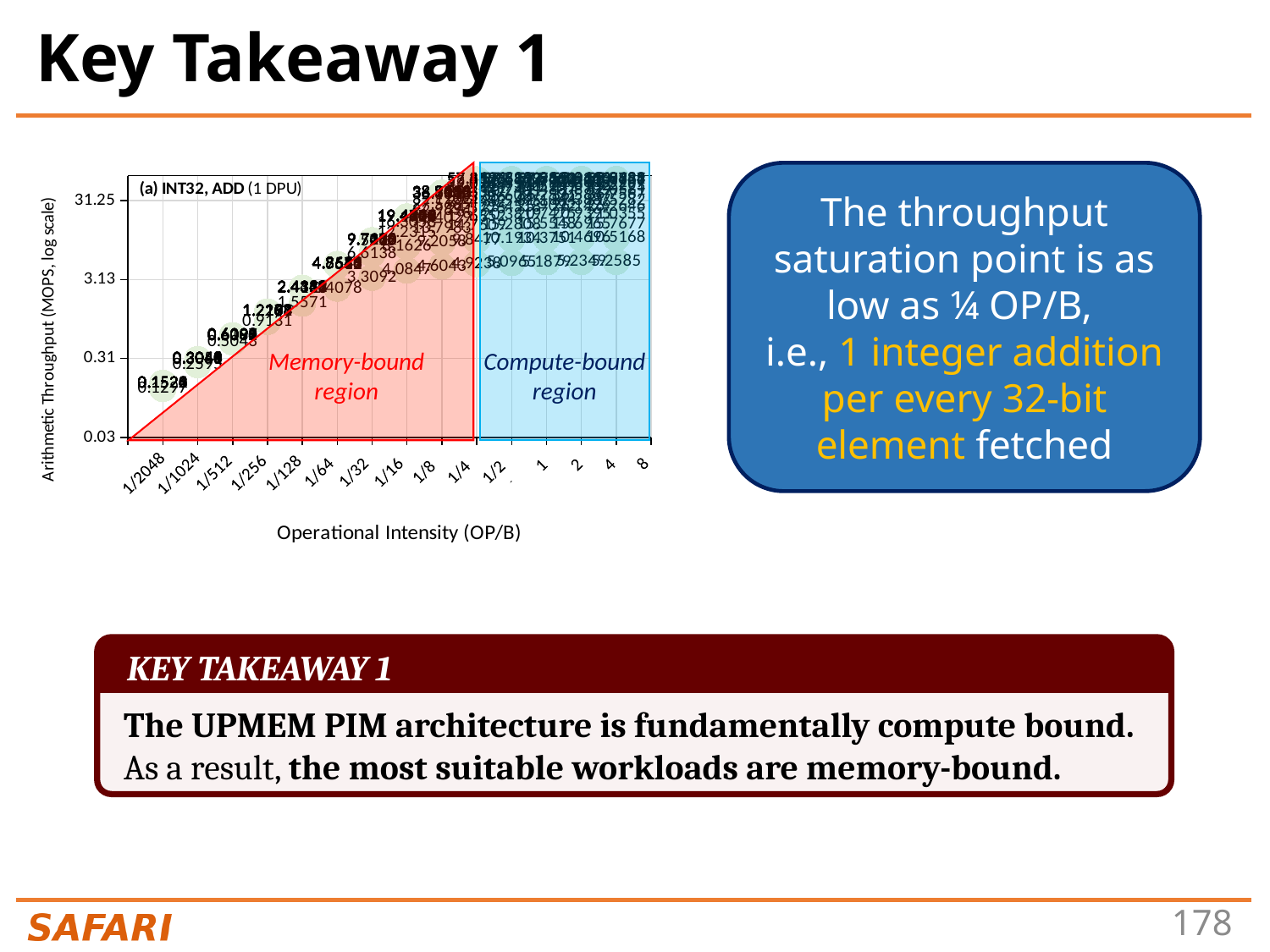
At which operational intensity is the arithmetic throughput lowest? 1/2048 What is the title printed inside the chart? (a) INT32, ADD (1 DPU) What kind of chart is shown on the slide? scatter chart Is the arithmetic throughput at operational intensity 8 greater or less than 3.13 MOPS? greater Is the arithmetic throughput at operational intensity 1/16 greater or less than 3.13 MOPS? greater Which has the higher arithmetic throughput: operational intensity 1/256 or 1/32? 1/32 Which has the higher arithmetic throughput: operational intensity 1/2048 or 8? 8 What are the two shaded regions in the chart labelled? Memory-bound region and Compute-bound region Is the arithmetic throughput at operational intensity 1/2048 greater or less than 0.31 MOPS? less How does arithmetic throughput change as operational intensity increases from 1/2048 to 1/4? It rises How many operational intensity values are marked on the x axis? 15